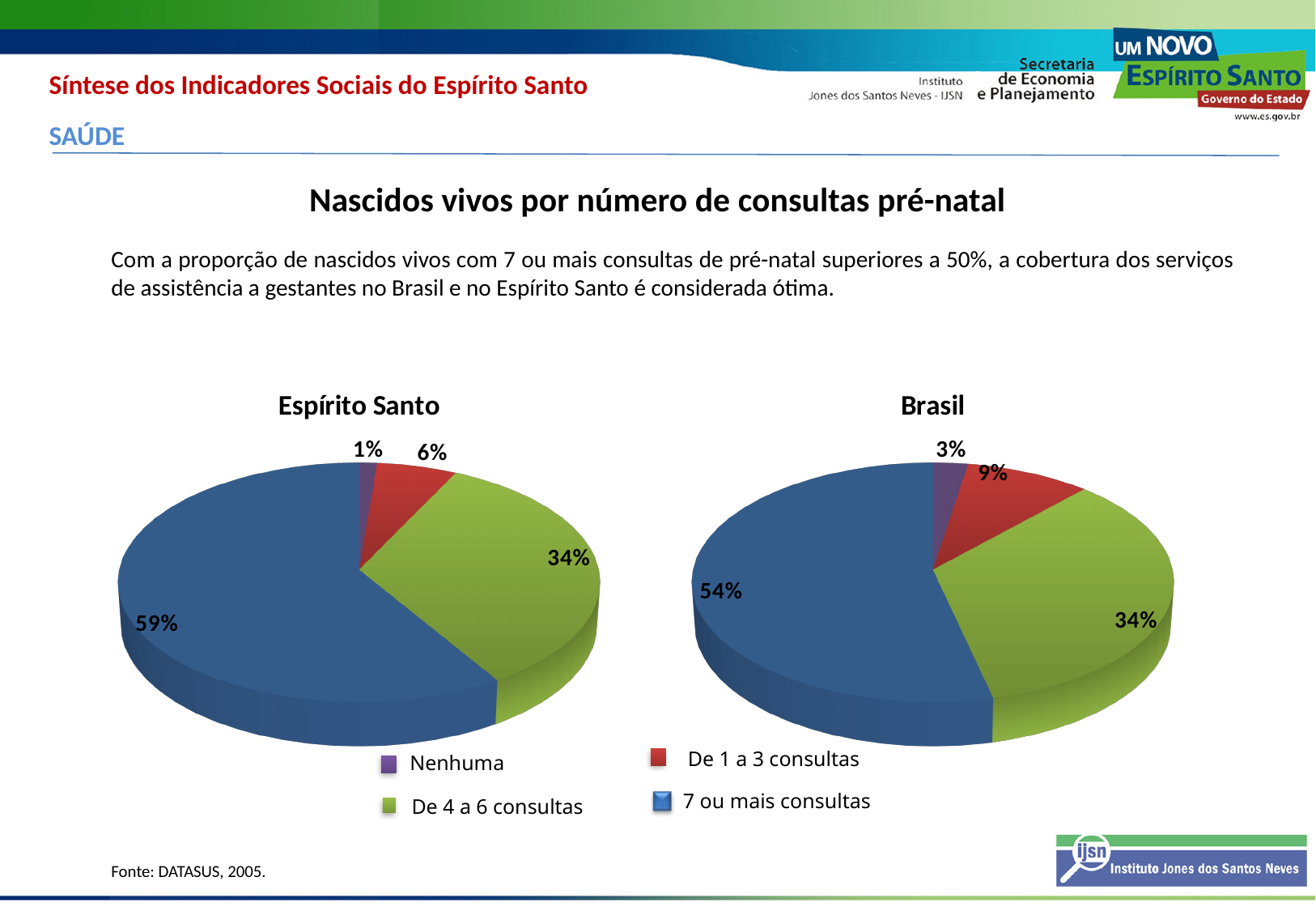
In the Brasil chart, which category has the largest slice? 7 ou mais consultas In the Brasil chart, what share of live births had 7 ou mais consultas? 54% In the Espírito Santo chart, which category has the smallest slice? Nenhuma In the Espírito Santo chart, what share corresponds to Nenhuma consulta? 1% What is the difference between the 7 ou mais consultas share in Espírito Santo and in Brasil? 5 percentage points In the Espírito Santo chart, what is the combined share of De 4 a 6 consultas and 7 ou mais consultas? 93% In the Brasil chart, what share corresponds to De 1 a 3 consultas? 9% Which has a larger share of De 1 a 3 consultas, Espírito Santo or Brasil? Brasil What type of chart is used for Espírito Santo and Brasil? Pie chart How many categories does the legend list? 4 Which colour represents 7 ou mais consultas in the charts? Blue In the Espírito Santo chart, what share of live births had 7 ou mais consultas? 59%